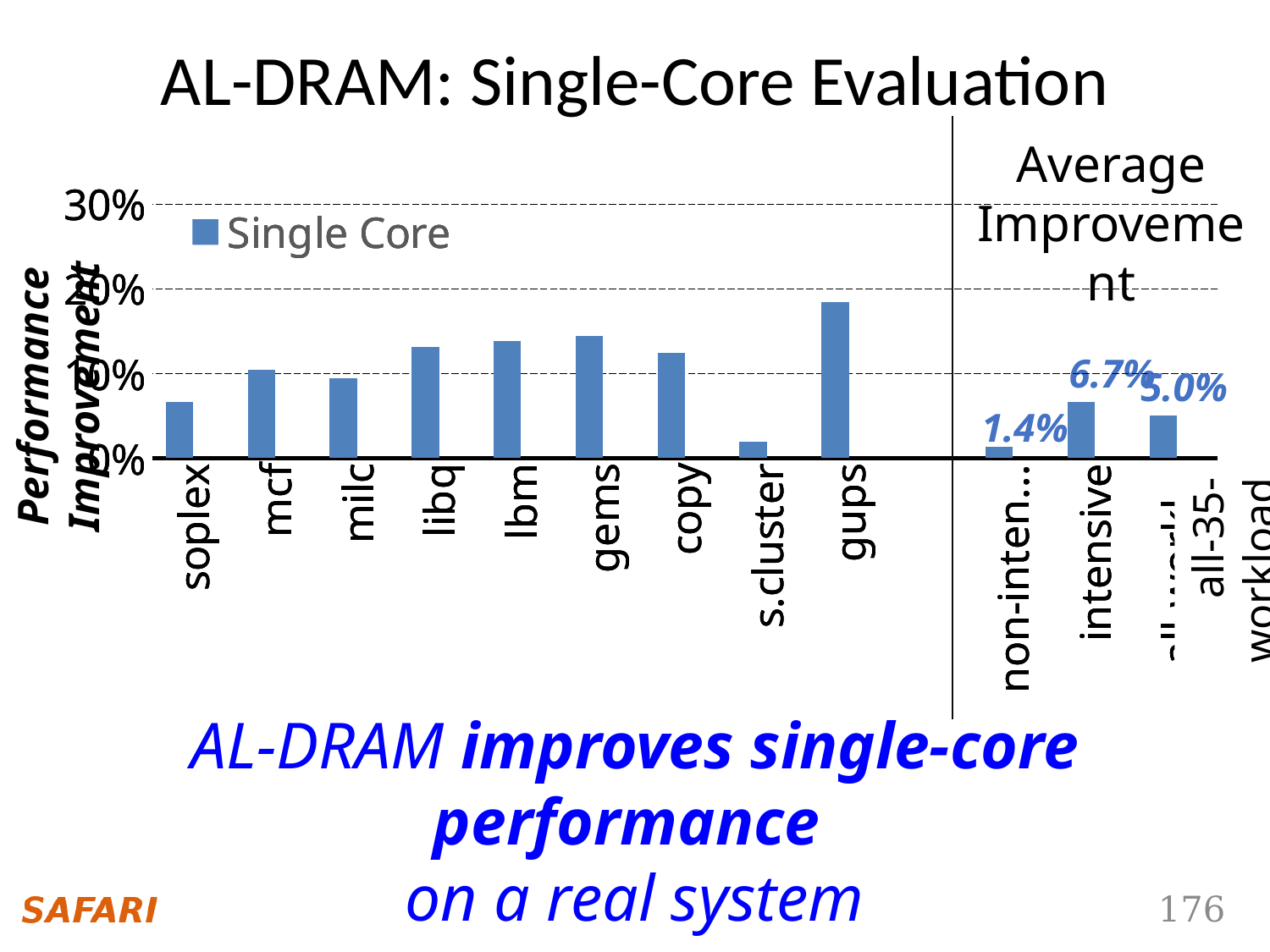
Is the performance improvement for s.cluster greater or less than 10%? less What is the average performance improvement across all 35 workloads? 5.0% Is the performance improvement for gups greater or less than 20%? less Which individual benchmark (left of the vertical divider) has the lowest performance improvement? s.cluster How many series does the legend list? 1 What is the average performance improvement for the intensive workloads? 6.7% How many bars are plotted to the left of the vertical divider line? 9 What is the difference between the average improvement for intensive workloads and for non-intensive workloads? 5.3% What is the average performance improvement for the non-intensive workloads? 1.4% Which has a larger performance improvement, gups or mcf? gups Which individual benchmark (left of the vertical divider) has the highest performance improvement? gups What kind of chart is shown on the slide? bar chart